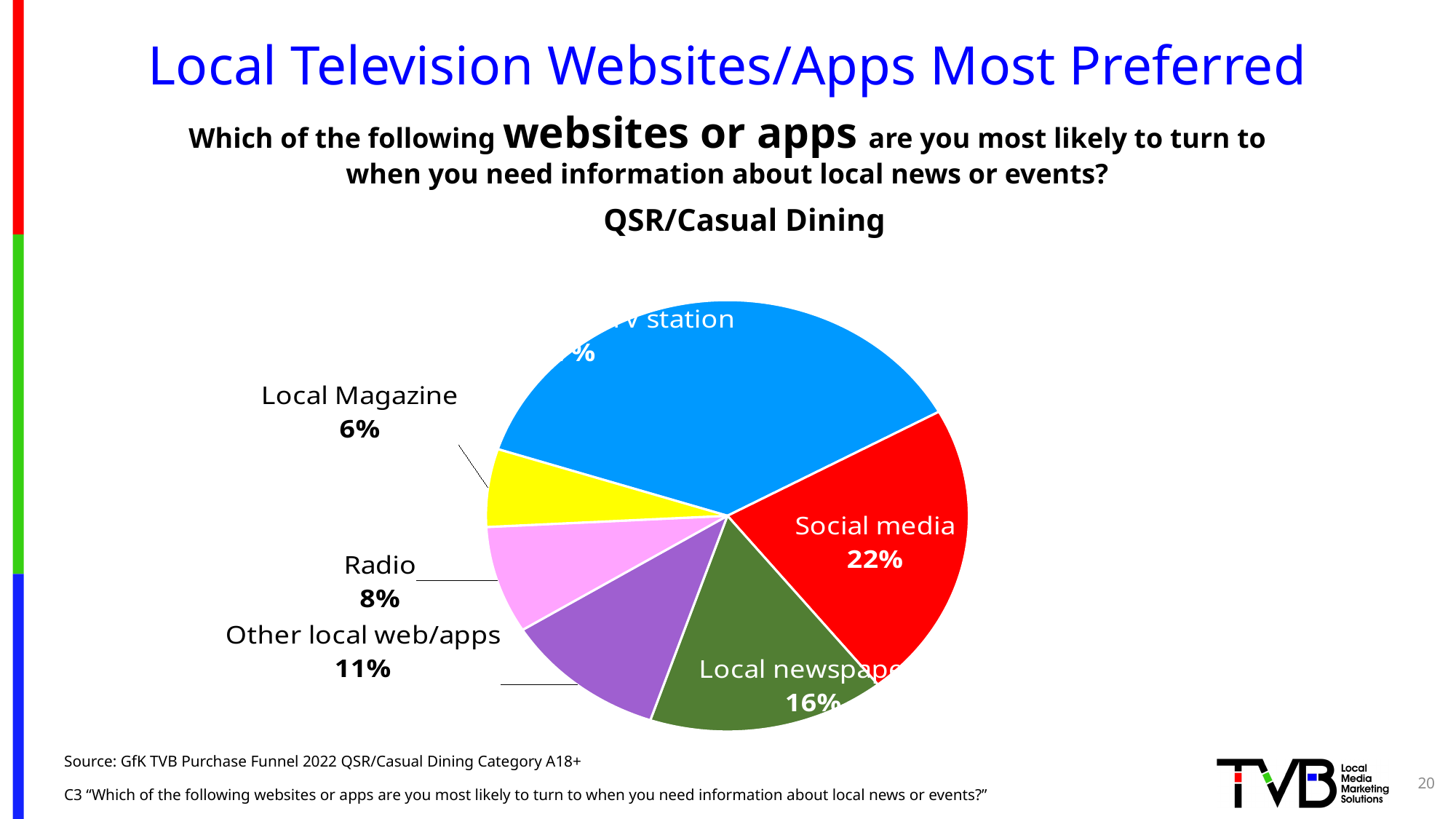
How many slices does the pie chart have? 6 Which category has the smallest slice of the pie? Local Magazine What colour is the Social media slice? red What is the value for Local newspaper? 16% What is the value for Other local web/apps? 11% What is the difference in percentage points between Radio and Local Magazine? 2 What is the difference in percentage points between Social media and Local newspaper? 6 What is the value for Radio? 8% Which is larger, the slice for Radio or the slice for Other local web/apps? Other local web/apps What kind of chart is shown on the slide? pie chart What is the value for Local Magazine? 6% What share of the pie does Social media have? 22%